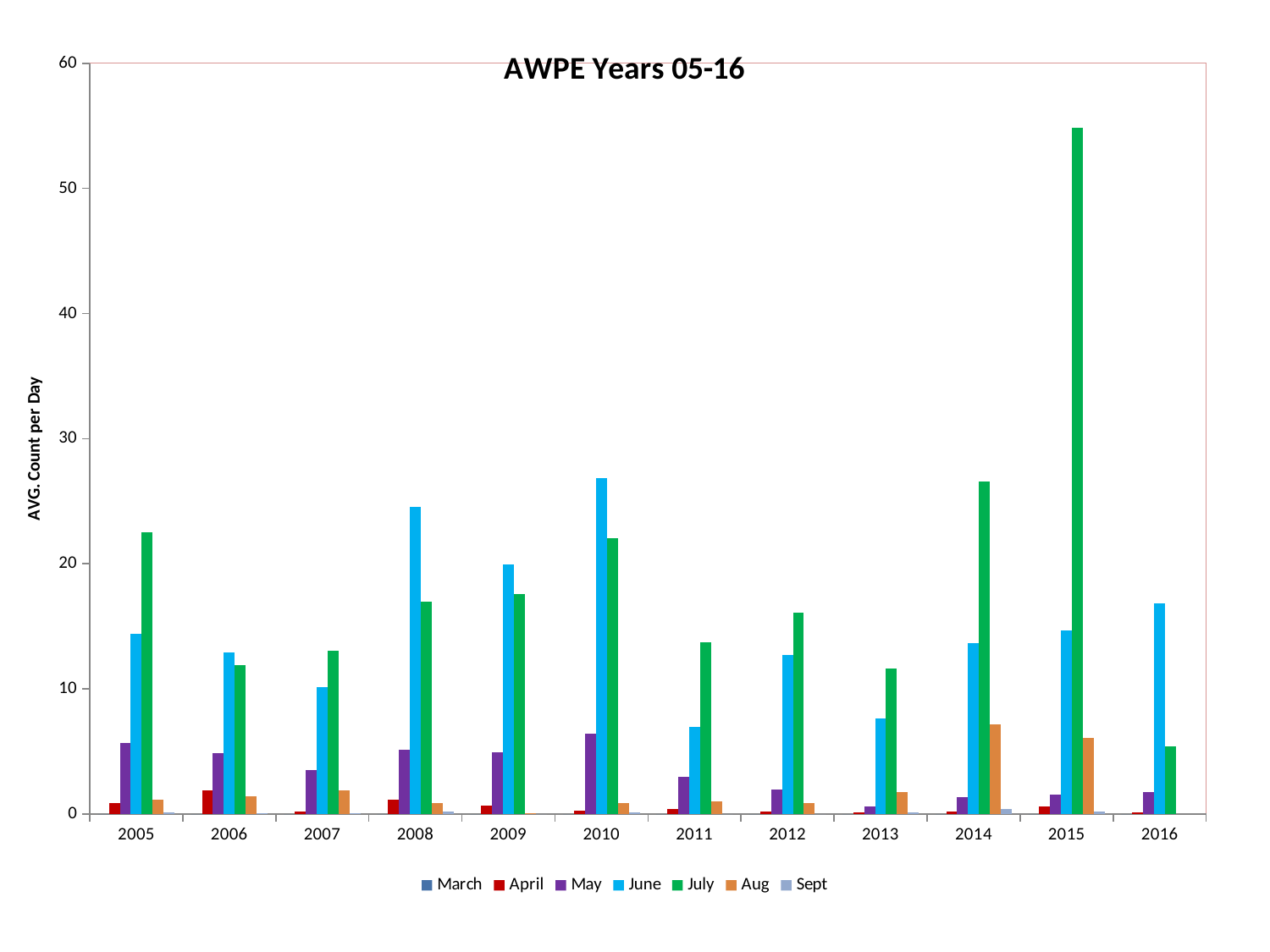
Is the July value for 2015 greater or less than 50? greater Is the June value for 2010 greater or less than 25? greater In 2005, which is larger, the June value or the July value? July Which year has the highest June value? 2010 Which year has the lowest July value? 2016 Which year has the highest July value? 2015 Is the Aug value for 2014 greater or less than 10? less What is the title of the chart? AWPE Years 05-16 What kind of chart is shown on the slide? bar chart In 2008, which is larger, the June value or the July value? June How many years are shown on the x axis? 12 How many series does the legend list? 7